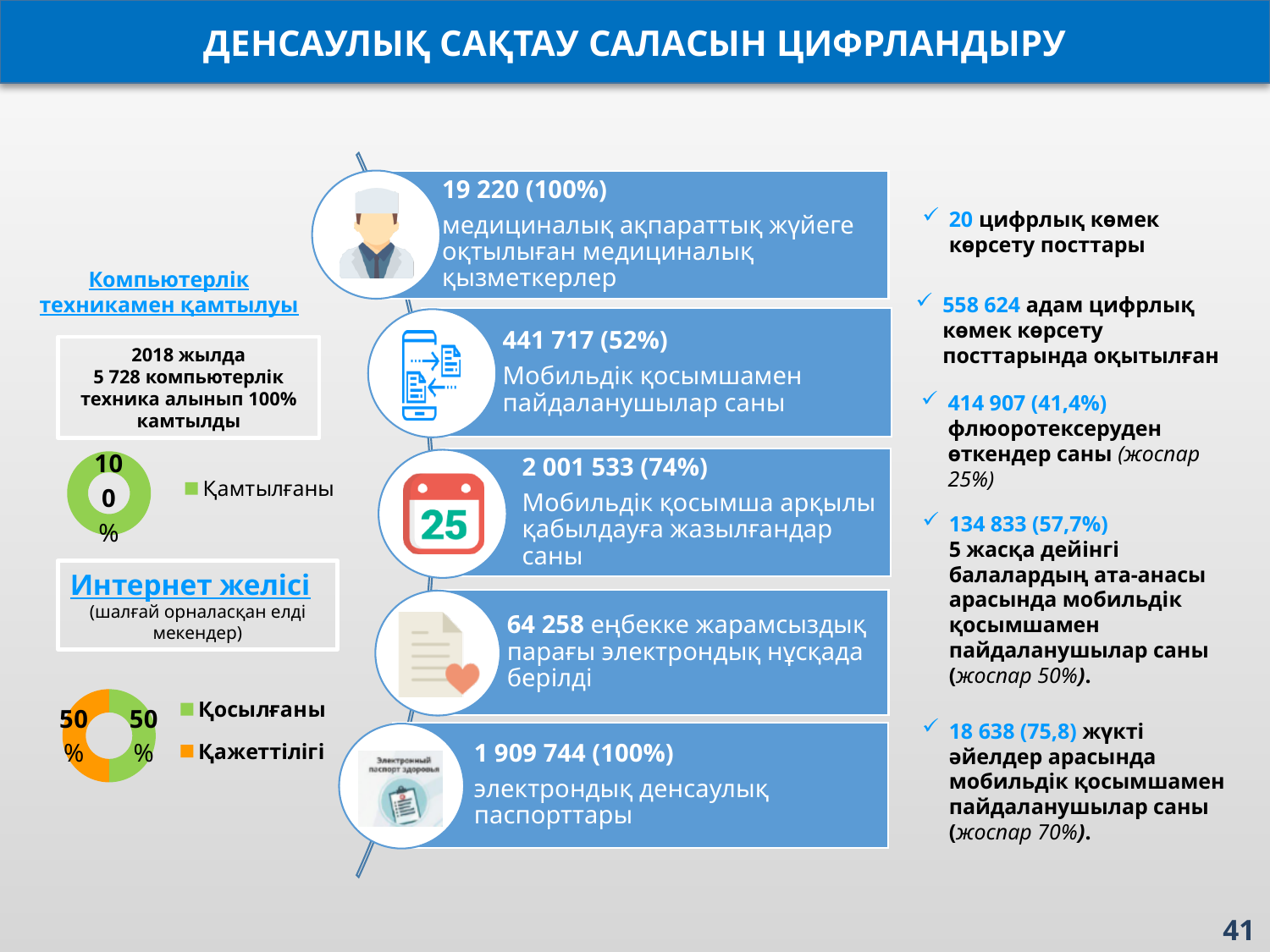
In the "Интернет желісі" chart, what share of the doughnut does Қажеттілігі take? 50% In the "Интернет желісі" chart, is the value for Қосылғаны larger than, smaller than, or equal to the value for Қажеттілігі? equal In the "Интернет желісі" chart, what is the difference between the values for Қосылғаны and Қажеттілігі? 0% In the "Интернет желісі" chart, what value is shown for Қажеттілігі? 50% How many entries does the legend of the "Компьютерлік техникамен қамтылуы" chart list? 1 In the "Компьютерлік техникамен қамтылуы" chart, what value is shown for Қамтылғаны? 100% How many entries does the legend of the "Интернет желісі" chart list? 2 What kind of chart is shown under the heading "Компьютерлік техникамен қамтылуы"? doughnut chart What colour is the Қажеттілігі segment in the "Интернет желісі" chart? orange What kind of chart is shown under the heading "Интернет желісі"? doughnut chart In the "Интернет желісі" chart, what value is shown for Қосылғаны? 50% What colour is the Қамтылғаны segment in the "Компьютерлік техникамен қамтылуы" chart? green